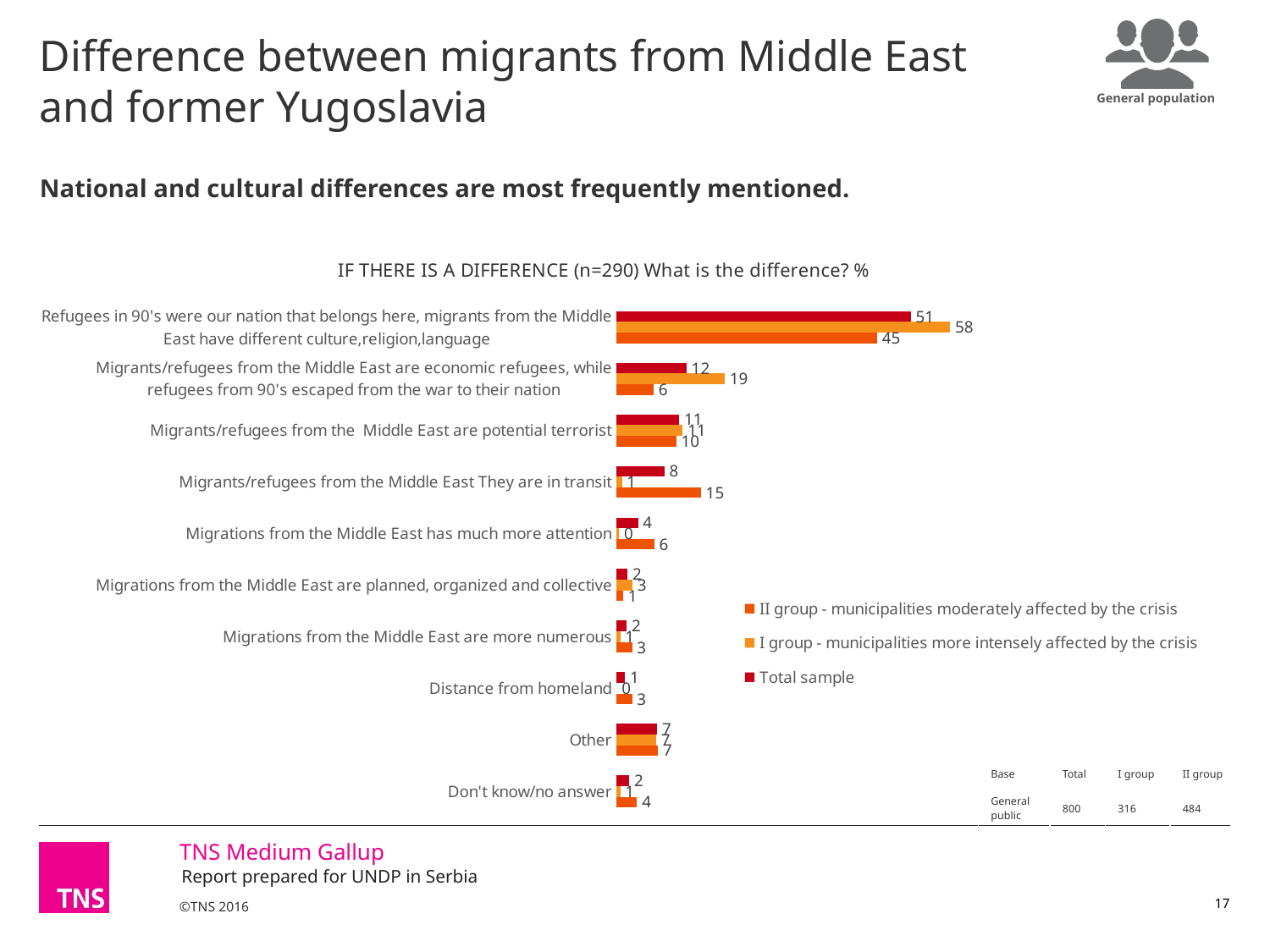
What is the I group value for "Migrants/refugees from the Middle East are economic refugees, while refugees from 90's escaped from the war to their nation"? 19 Which category has the highest Total sample value? Refugees in 90's were our nation that belongs here, migrants from the Middle East have different culture,religion,language How many series does the legend list? 3 What is the Total sample value for "Refugees in 90's were our nation that belongs here, migrants from the Middle East have different culture,religion,language"? 51 What is the difference between the I group and II group values for "Refugees in 90's were our nation that belongs here, migrants from the Middle East have different culture,religion,language"? 13 What is the title of the chart? IF THERE IS A DIFFERENCE (n=290) What is the difference? % What is the II group value for "Migrants/refugees from the Middle East They are in transit"? 15 For "Migrants/refugees from the Middle East They are in transit", which is larger: the I group value or the II group value? II group What kind of chart is shown on the slide? Bar chart What is the Total sample value for "Other"? 7 How many categories are shown on the chart? 10 What is the I group value for "Migrations from the Middle East has much more attention"? 0